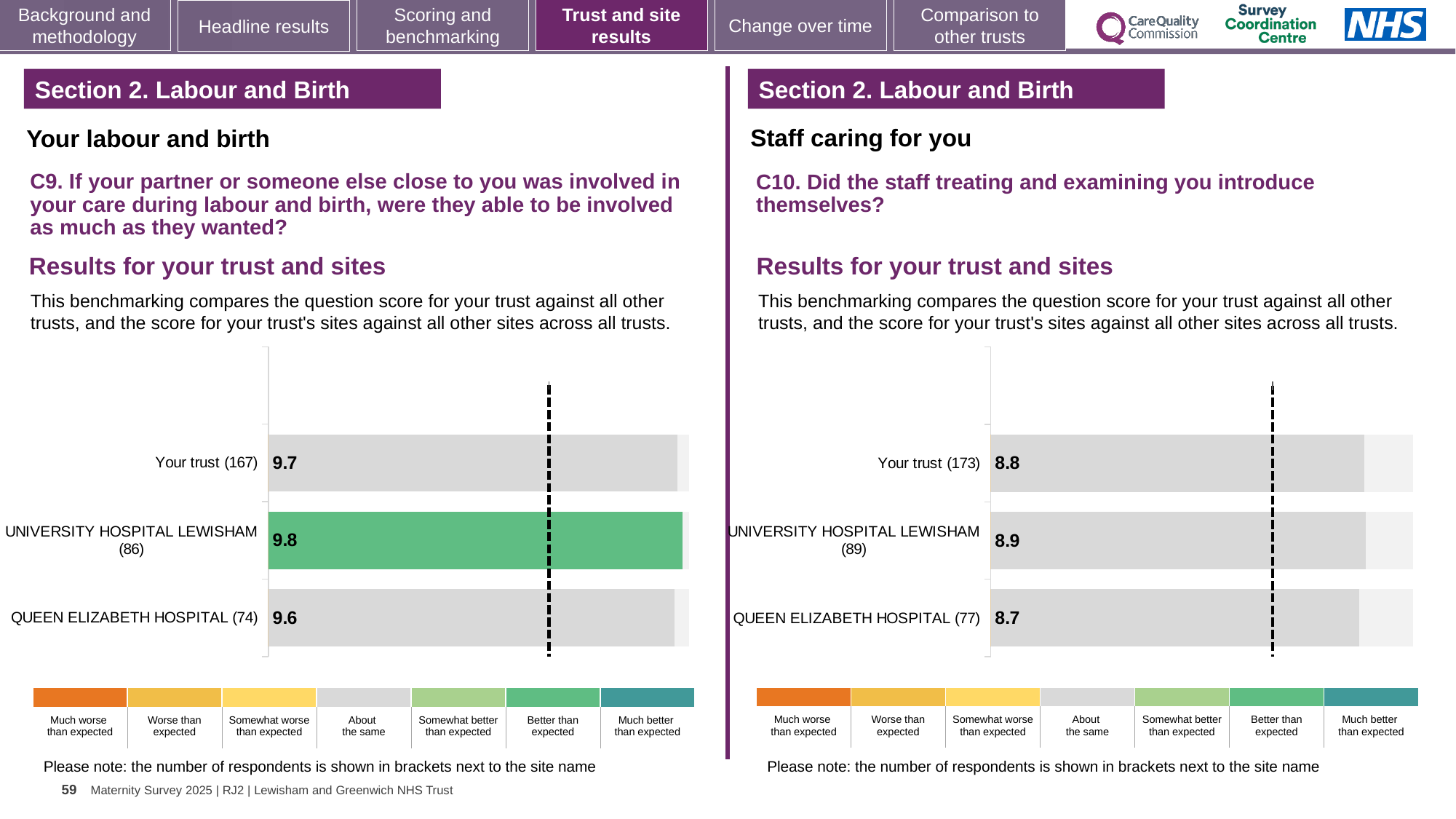
In the C9 chart on the left, what is the score for University Hospital Lewisham? 9.8 In the C9 chart on the left, which site or trust has the highest score? University Hospital Lewisham In the C9 chart on the left, what is the score for Your trust? 9.7 How many bars are shown in the C10 chart on the right? 3 In the C10 chart on the right, which site or trust has the lowest score? Queen Elizabeth Hospital In the C10 chart on the right, what is the score for Queen Elizabeth Hospital? 8.7 In the C10 chart on the right, what is the difference between the scores for University Hospital Lewisham and Your trust? 0.1 In the C9 chart on the left, how many respondents are shown in brackets for University Hospital Lewisham? 86 In the C9 chart on the left, what is the score for Queen Elizabeth Hospital? 9.6 What type of chart is used in the C9 chart on the left? Bar chart In the C9 chart on the left, what is the difference between the scores for University Hospital Lewisham and Queen Elizabeth Hospital? 0.2 In the C10 chart on the right, what is the score for Your trust? 8.8